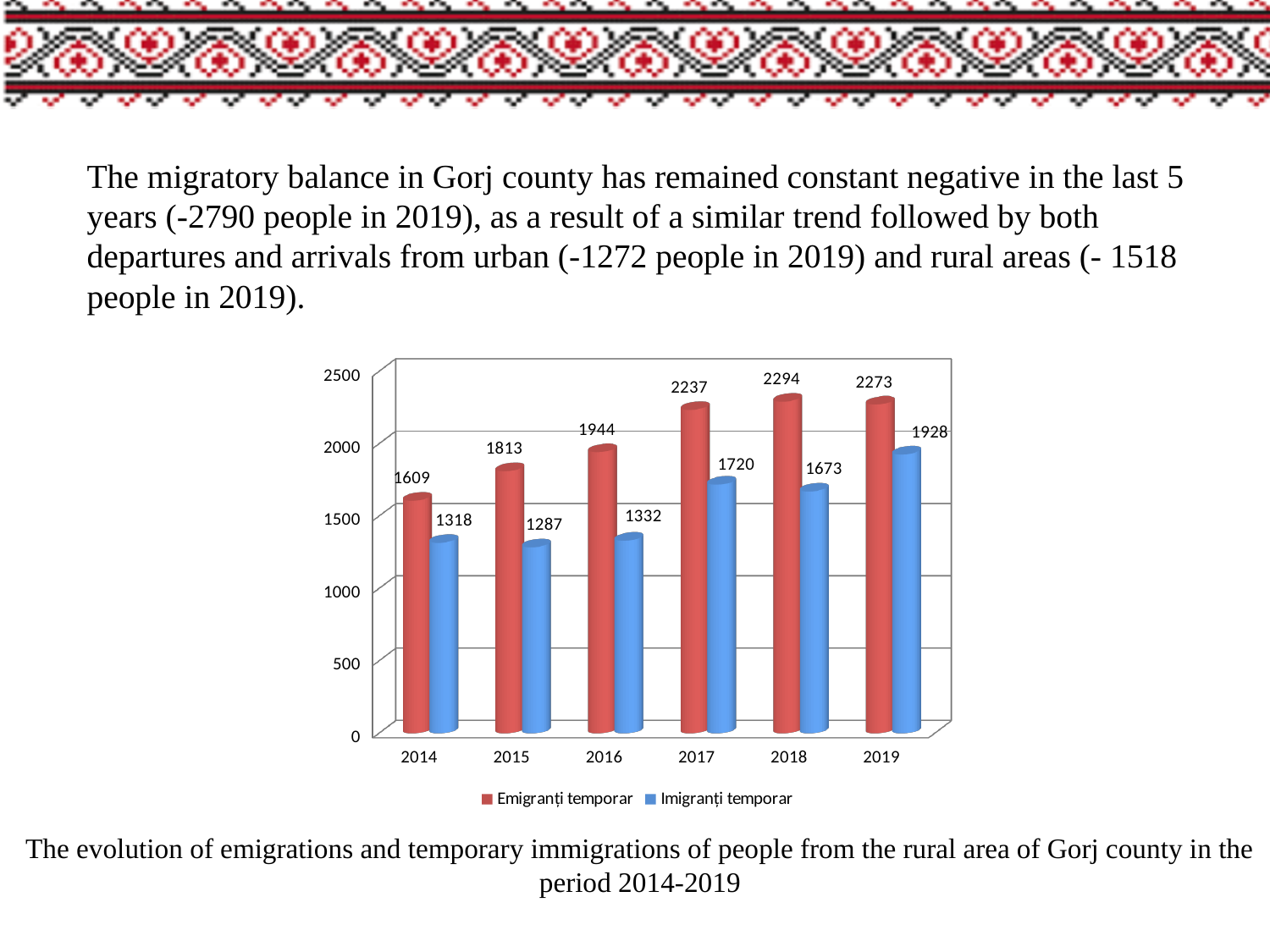
What kind of chart is shown on the slide? bar chart What is the value for Imigranți temporar in 2019? 1928 In which year is Emigranți temporar highest? 2018 What is the difference between Emigranți temporar and Imigranți temporar in 2019? 345 Which is larger in 2016: Emigranți temporar or Imigranți temporar? Emigranți temporar How many series does the legend list? 2 Is the value for Emigranți temporar in 2014 greater or less than 1500? greater In which year is Imigranți temporar lowest? 2015 Does Imigranți temporar rise or fall from 2016 to 2017? rise What is the value for Imigranți temporar in 2015? 1287 What is the value for Emigranți temporar in 2017? 2237 How many years are shown on the x axis? 6